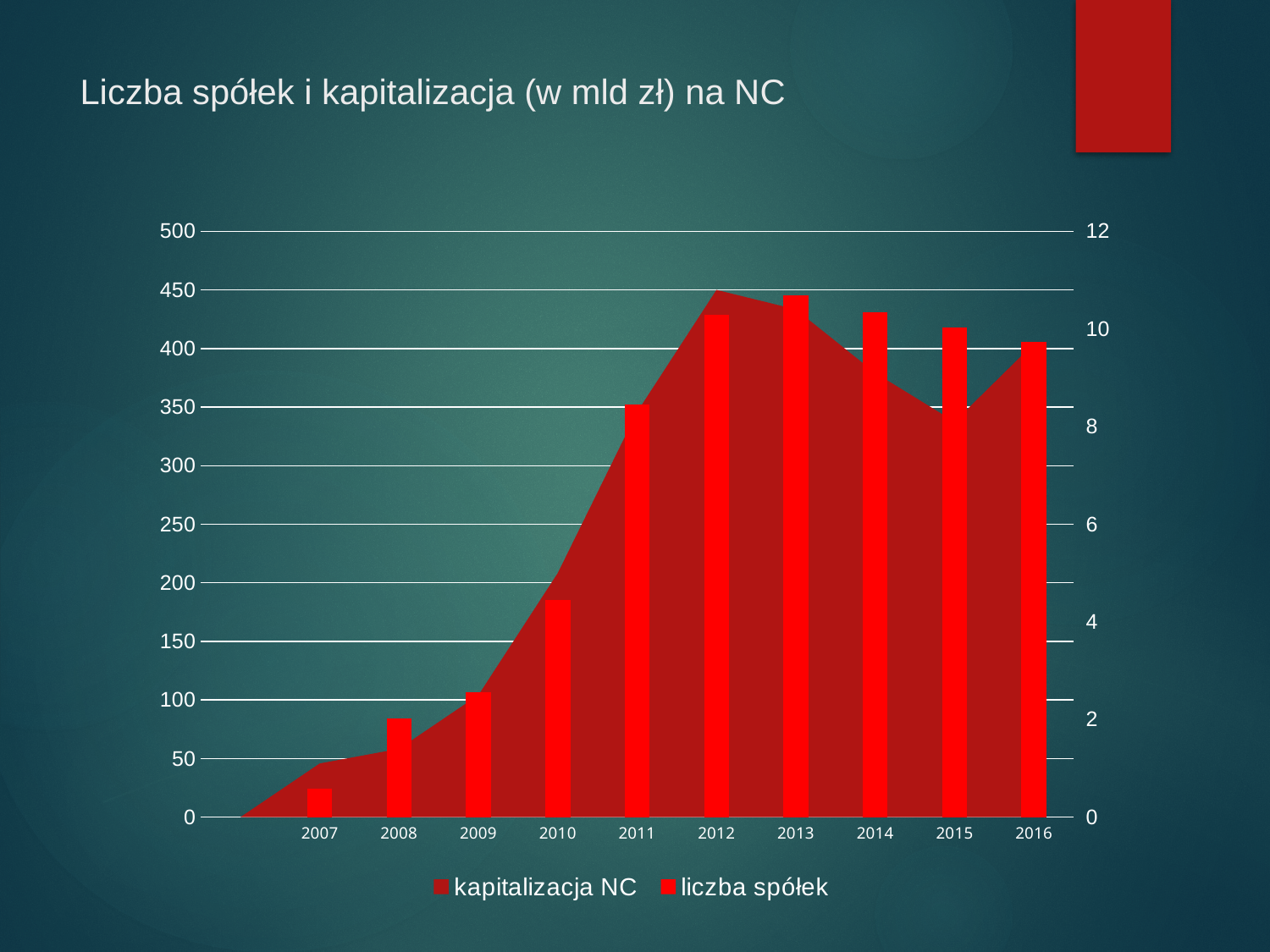
Do the liczba spółek bars rise or fall from 2007 to 2013? rise Which year has the taller liczba spółek bar, 2010 or 2011? 2011 How many series does the legend list? 2 In which year is the liczba spółek bar the tallest? 2013 Is the liczba spółek bar for 2010 greater or less than 200 on the left axis? less In which year is the liczba spółek bar the shortest? 2007 What kind of chart is this? A combination chart with an area series and a bar series Is the liczba spółek bar for 2007 greater or less than 50 on the left axis? less What is the title of the chart? Liczba spółek i kapitalizacja (w mld zł) na NC What are the two series named in the legend? kapitalizacja NC and liczba spółek How many years are shown on the x axis? 10 Is the liczba spółek bar for 2012 greater or less than 400 on the left axis? greater